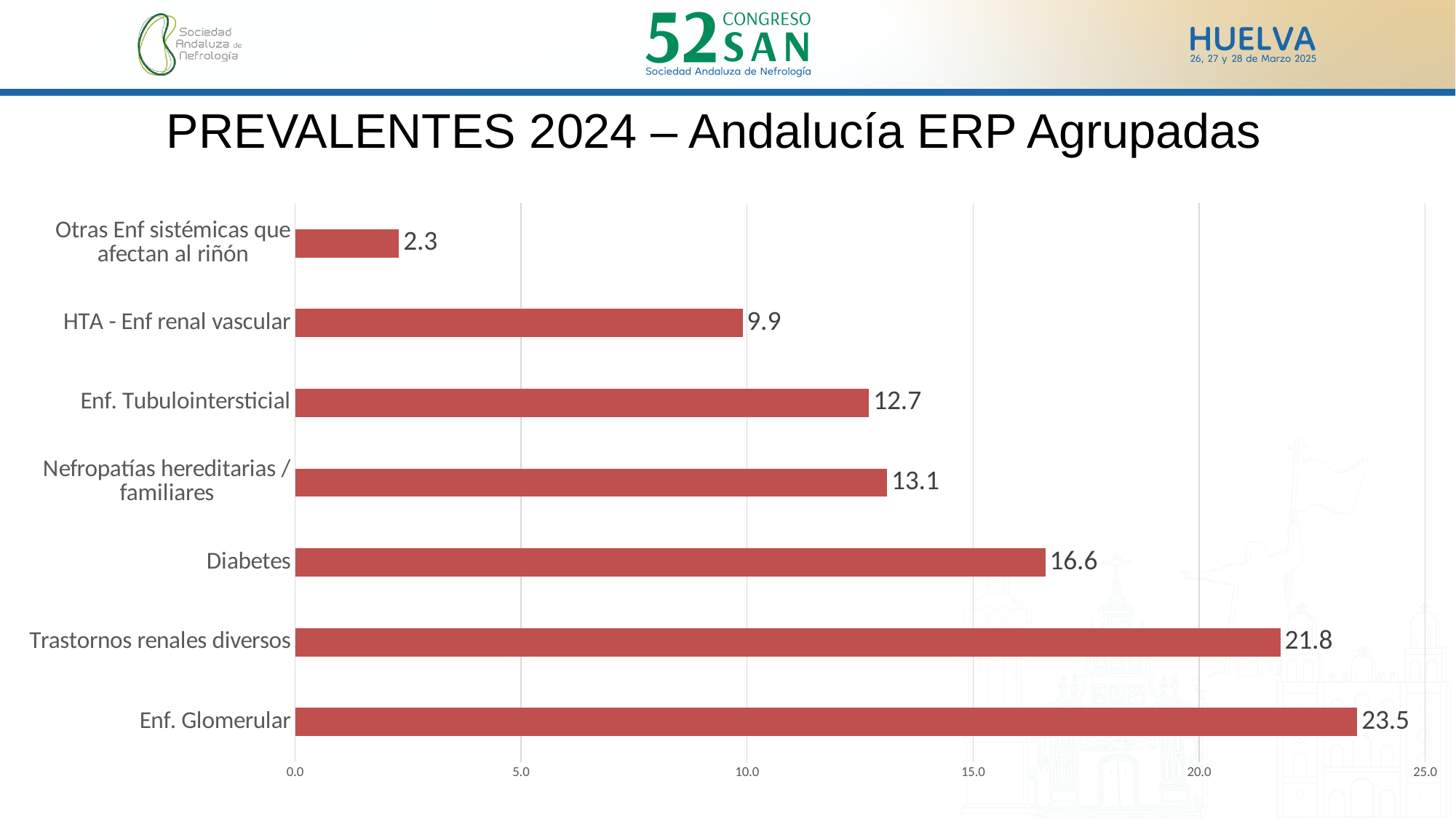
Which category has the lowest value? Otras Enf sistémicas que afectan al riñón What kind of chart is shown on the slide? Bar chart What is the value for Diabetes? 16.6 Is the value for Trastornos renales diversos greater or less than 20.0? greater Which category has the highest value? Enf. Glomerular What is the value for Otras Enf sistémicas que afectan al riñón? 2.3 What is the difference between the values for Enf. Glomerular and Trastornos renales diversos? 1.7 How many categories are shown in the chart? 7 Which is larger, the value for Diabetes or the value for Enf. Tubulointersticial? Diabetes What is the difference between the values for Diabetes and HTA - Enf renal vascular? 6.7 What is the value for HTA - Enf renal vascular? 9.9 What is the value for Enf. Glomerular? 23.5